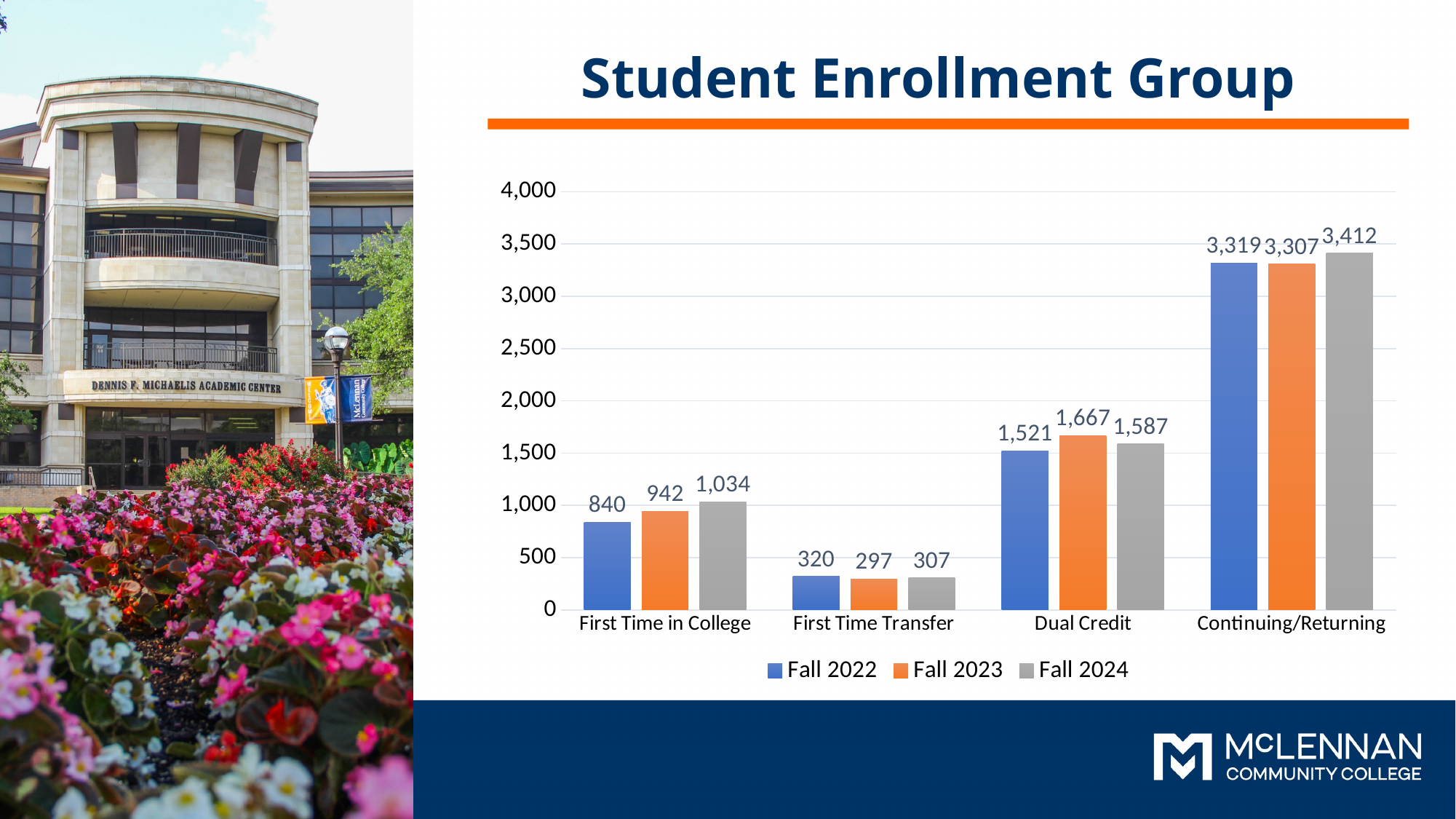
Which category has the highest Fall 2024 value? Continuing/Returning What is the title of the chart? Student Enrollment Group What kind of chart is shown on the slide? bar chart How many series does the legend list? 3 What is the difference between the Fall 2024 and Fall 2022 values for First Time in College? 194 What is the Fall 2022 value for Dual Credit? 1,521 Which is larger for Dual Credit: the Fall 2023 value or the Fall 2024 value? Fall 2023 Is the Fall 2022 value for Continuing/Returning greater or less than 3,000? greater What is the Fall 2023 value for Continuing/Returning? 3,307 What is the Fall 2024 value for First Time in College? 1,034 How many categories are shown on the x axis? 4 Which category has the lowest Fall 2022 value? First Time Transfer